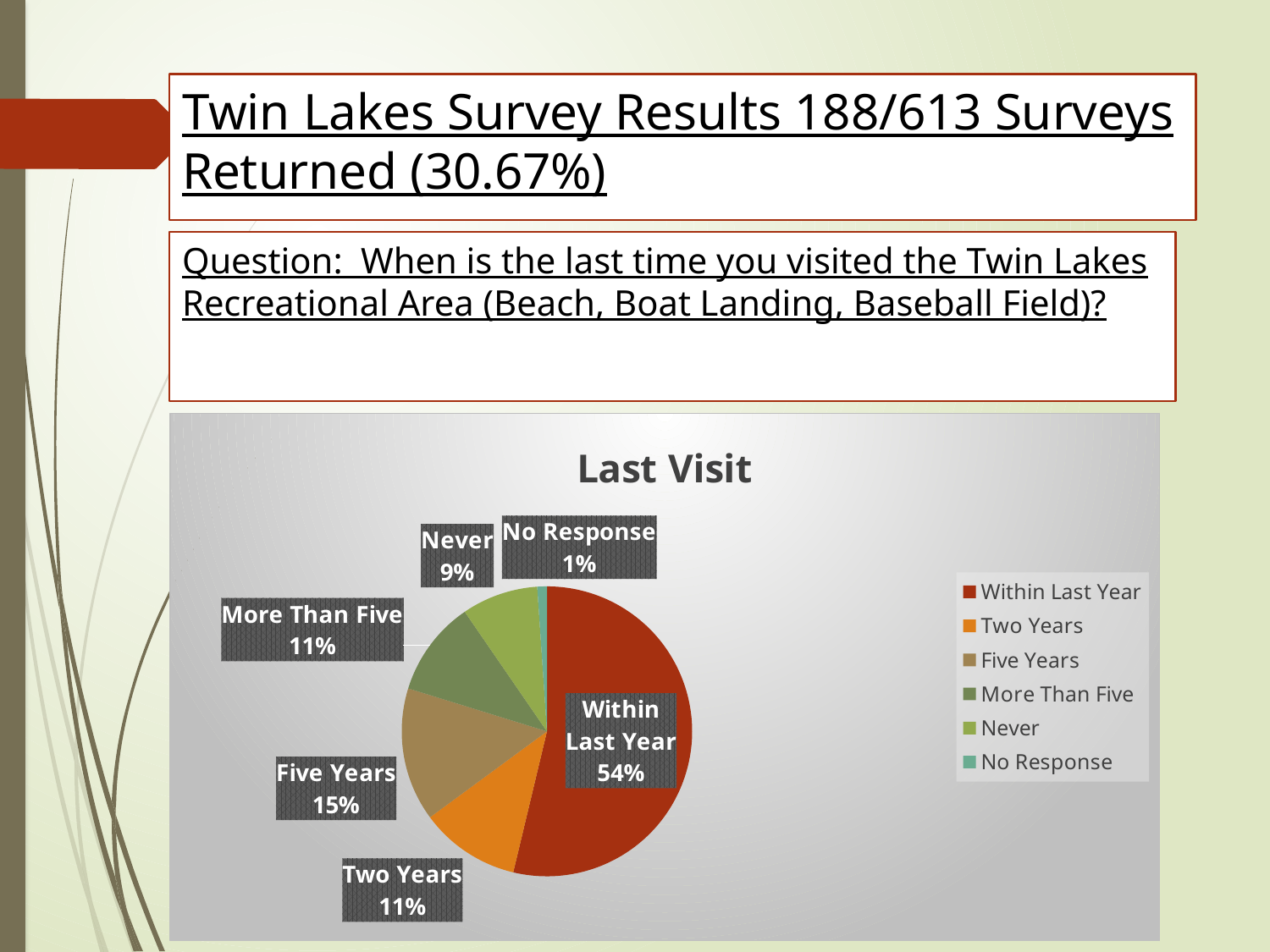
Which category has the largest slice of the pie? Within Last Year Which category has the smallest slice of the pie? No Response How many categories does the legend list? 6 What is the difference in percentage points between Within Last Year and Five Years? 39 What percentage is shown for More Than Five? 11% Which is larger, the Five Years slice or the Never slice? Five Years What is the title of the chart? Last Visit What kind of chart is shown on the slide? pie chart What percentage is shown for Never? 9% What percentage is shown for No Response? 1% What percentage is shown for Five Years? 15% What share of the pie is labelled Within Last Year? 54%